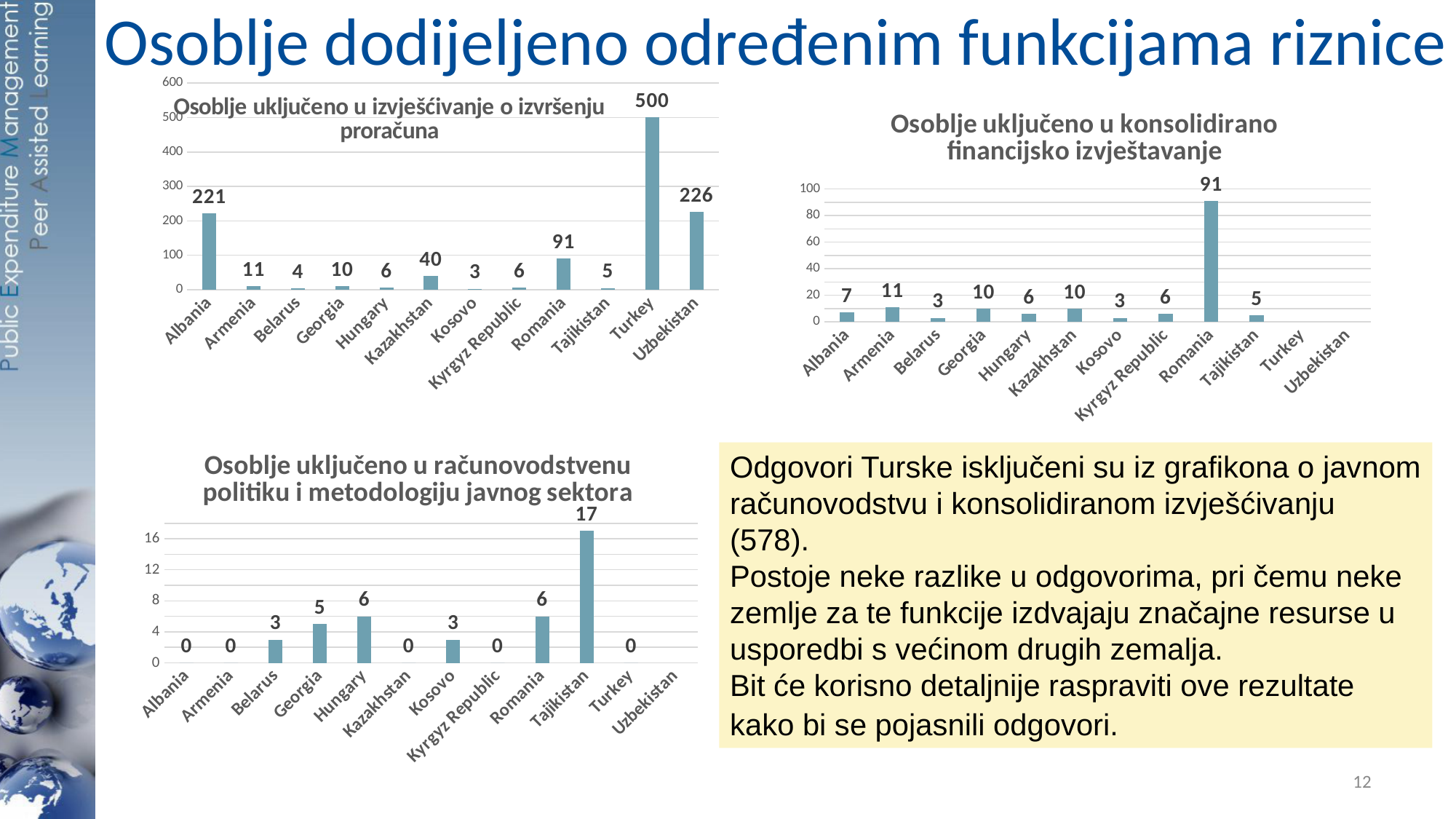
In the chart 'Osoblje uključeno u izvješćivanje o izvršenju proračuna', which is larger, Romania or Kazakhstan? Romania In the chart 'Osoblje uključeno u konsolidirano financijsko izvještavanje', what is the value for Albania? 7 In the chart 'Osoblje uključeno u izvješćivanje o izvršenju proračuna', what is the difference between Uzbekistan and Albania? 5 In the chart 'Osoblje uključeno u računovodstvenu politiku i metodologiju javnog sektora', what is the difference between Tajikistan and Hungary? 11 How many countries are listed on the x axis of the chart 'Osoblje uključeno u računovodstvenu politiku i metodologiju javnog sektora'? 12 What type of chart is 'Osoblje uključeno u konsolidirano financijsko izvještavanje'? Bar chart In the chart 'Osoblje uključeno u izvješćivanje o izvršenju proračuna', what is the value for Kazakhstan? 40 In the chart 'Osoblje uključeno u konsolidirano financijsko izvještavanje', what is the value for Romania? 91 In the chart 'Osoblje uključeno u izvješćivanje o izvršenju proračuna', which country has the highest value? Turkey In the chart 'Osoblje uključeno u izvješćivanje o izvršenju proračuna', what is the value for Turkey? 500 In the chart 'Osoblje uključeno u računovodstvenu politiku i metodologiju javnog sektora', what is the value for Tajikistan? 17 In the chart 'Osoblje uključeno u konsolidirano financijsko izvještavanje', which country has the highest value? Romania